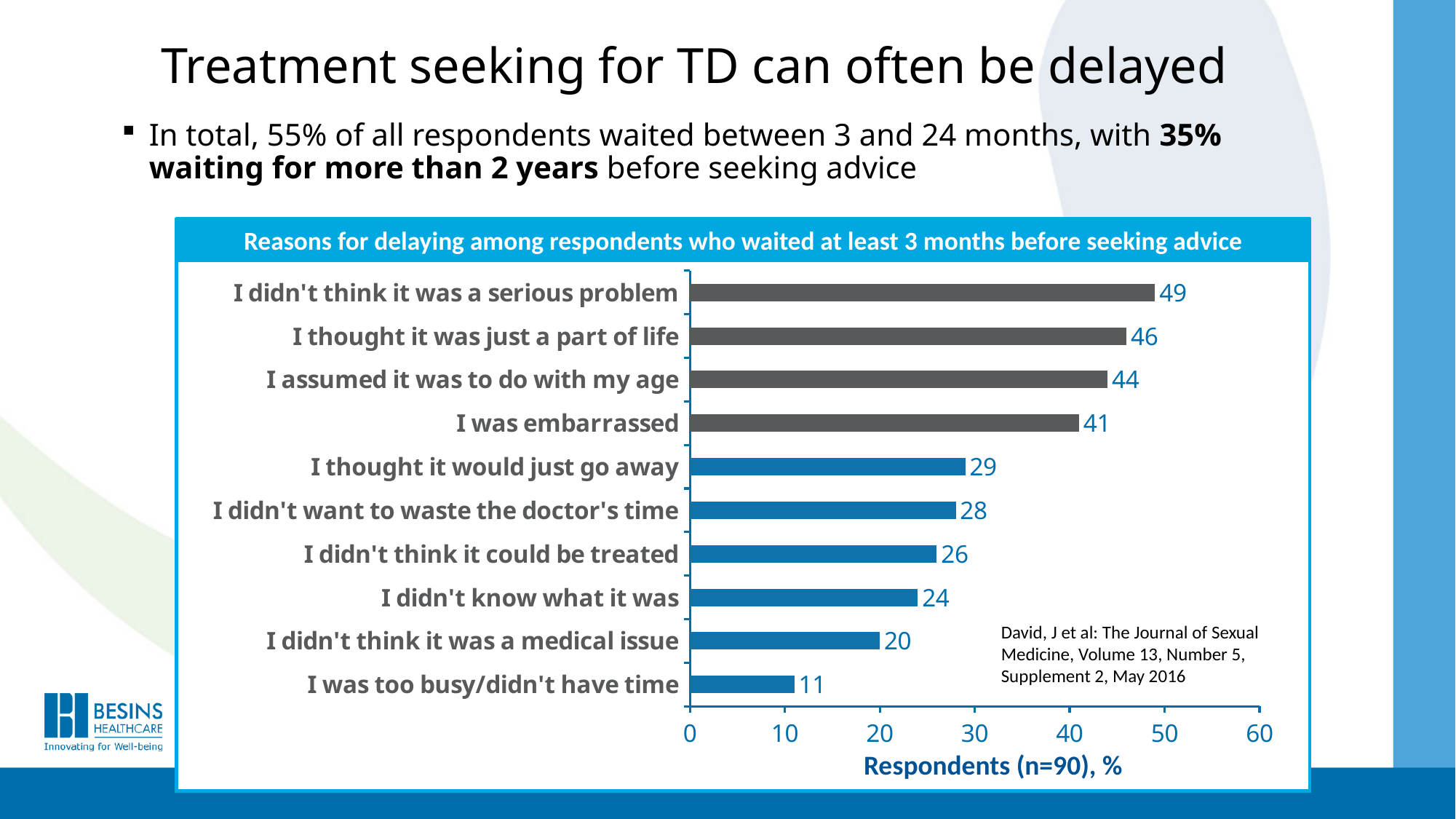
What is the value for "I didn't know what it was"? 24 What is the label of the horizontal axis of the chart? Respondents (n=90), % Which reason has the lowest value in the chart? I was too busy/didn't have time What is the value for "I was embarrassed"? 41 What type of chart is shown on the slide? Bar chart Is the value for "I didn't think it was a medical issue" greater or less than 30? less What is the difference between the highest and lowest values in the chart? 38 How many reasons (categories) are shown in the chart? 10 Which is larger: the value for "I thought it would just go away" or "I didn't think it could be treated"? I thought it would just go away What is the difference between the values for "I thought it was just a part of life" and "I assumed it was to do with my age"? 2 Which reason has the highest value in the chart? I didn't think it was a serious problem What percentage of respondents gave "I didn't think it was a serious problem" as a reason for delaying? 49